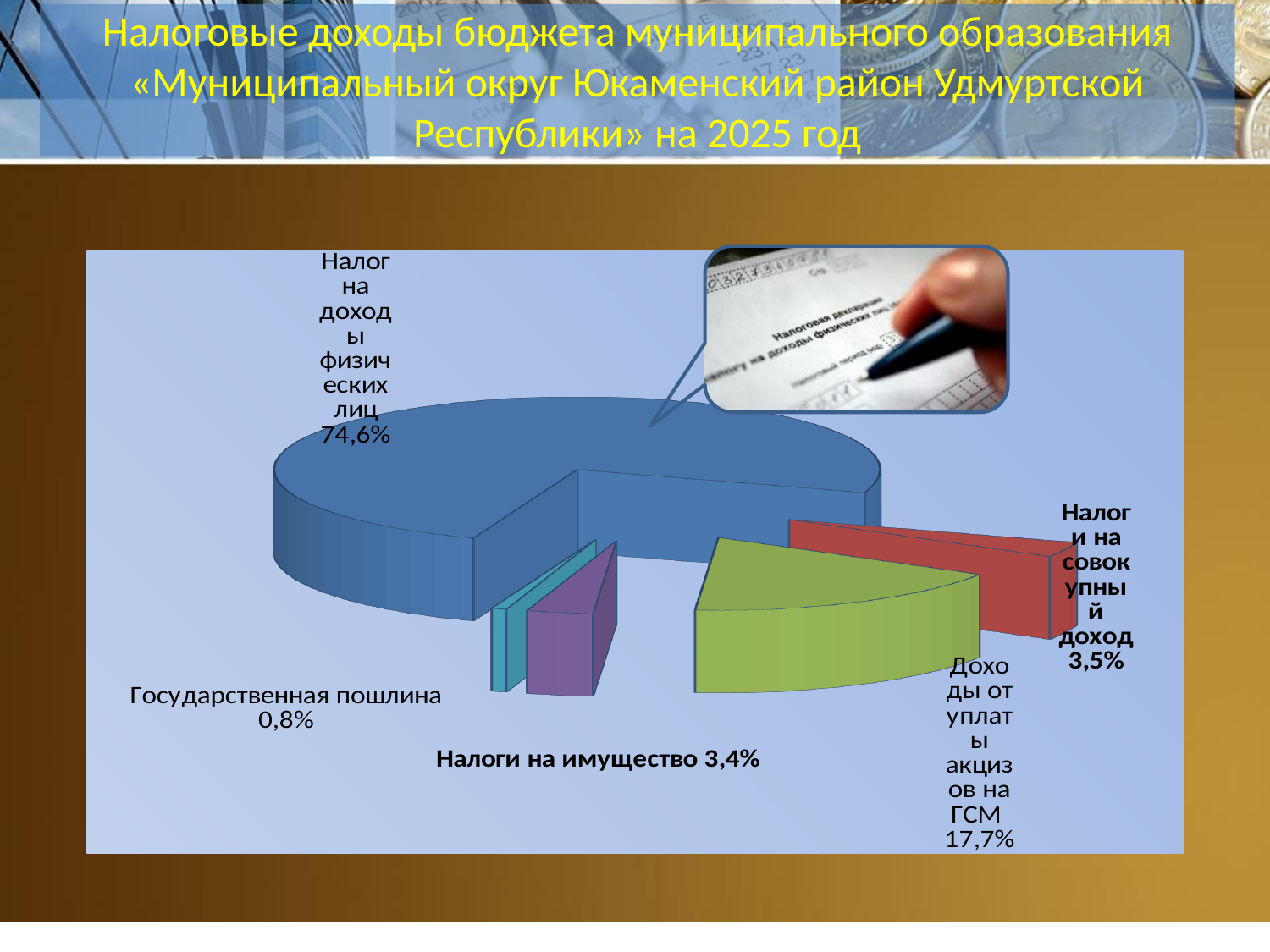
What is the difference between the shares of «Налоги на совокупный доход» and «Налоги на имущество»? 0,1% What kind of chart is shown on the slide? Pie chart What value is shown for «Налоги на имущество»? 3,4% What share of the pie does «Налог на доходы физических лиц» have? 74,6% What is the difference between the shares of «Налог на доходы физических лиц» and «Доходы от уплаты акцизов на ГСМ»? 56,9% Which category has the largest share of the pie? Налог на доходы физических лиц Which category has the smallest share of the pie? Государственная пошлина Which is larger: «Доходы от уплаты акцизов на ГСМ» or «Налоги на совокупный доход»? Доходы от уплаты акцизов на ГСМ What value is shown for «Налоги на совокупный доход»? 3,5% What share of the pie does «Доходы от уплаты акцизов на ГСМ» have? 17,7% What value is shown for «Государственная пошлина»? 0,8% How many slices does the pie chart have? 5